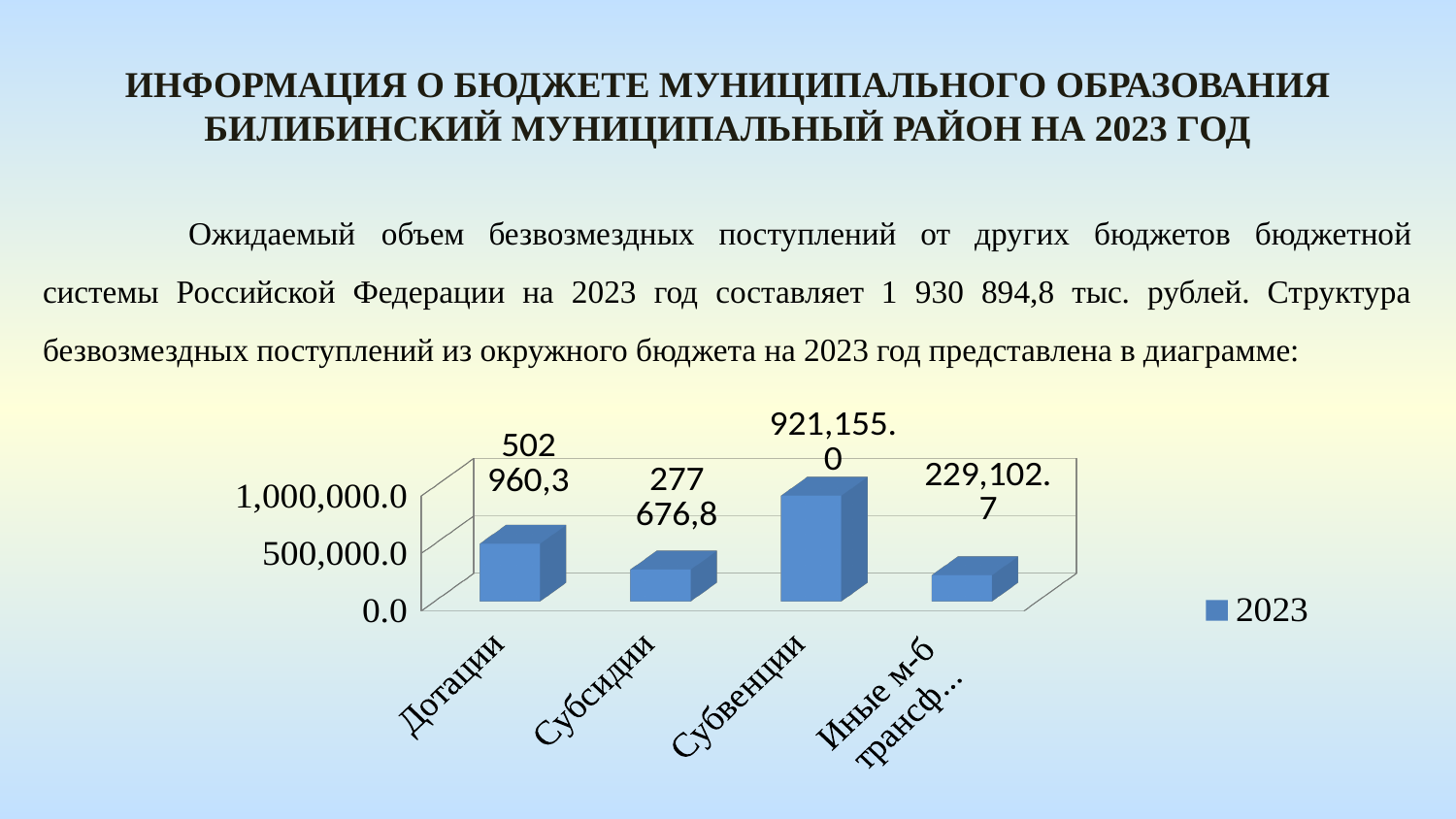
Is the value for Субсидии greater or less than 500,000.0? less Which category has the lowest value? Иные м-б трансф... Is the value for Субвенции greater or less than 500,000.0? greater What kind of chart is shown on the slide? Bar chart Which is larger, the value for Дотации or the value for Субсидии? Дотации What value is shown for Субсидии? 277 676,8 How many series does the legend list? 1 What value is shown for the fourth category, Иные м-б трансф...? 229,102.7 What value is shown for Дотации? 502 960,3 Which category has the highest value? Субвенции What value is shown for Субвенции? 921,155.0 How many categories are shown on the chart? 4